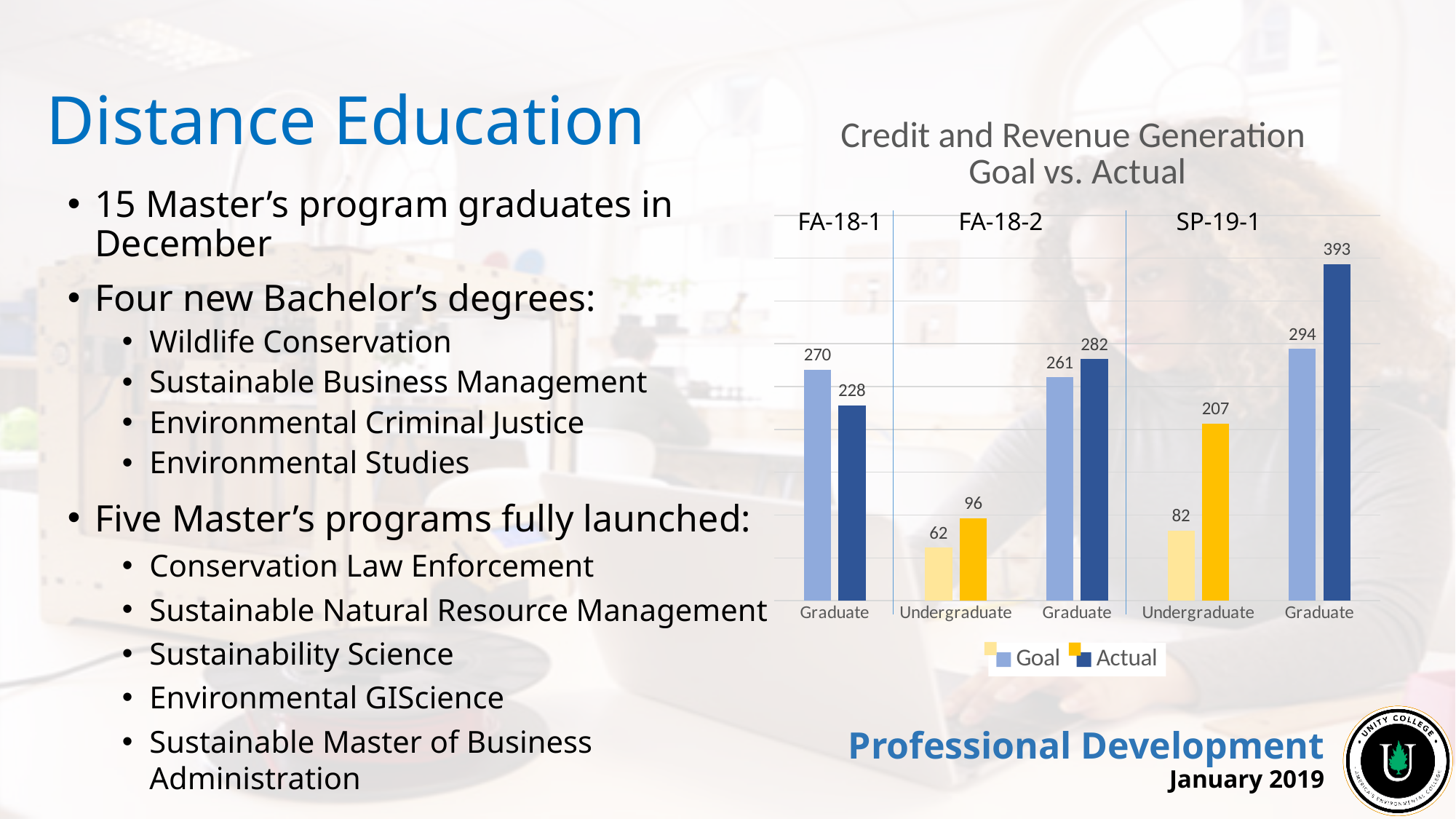
What is the difference between the Actual and Goal values for Undergraduate in SP-19-1? 125 What is the Goal value for Undergraduate in FA-18-2? 62 What is the difference between the Actual and Goal values for Graduate in SP-19-1? 99 What type of chart is shown on the slide? Bar chart Which category has the lowest Goal value? Undergraduate in FA-18-2 What is the Actual value for Graduate in FA-18-1? 228 How many category groups are shown on the x axis? 5 For Graduate in FA-18-1, which is larger, the Goal or the Actual value? Goal Which category has the highest Actual value? Graduate in SP-19-1 What is the Goal value for Graduate in FA-18-1? 270 How many series does the legend list? 2 What is the Actual value for Undergraduate in SP-19-1? 207